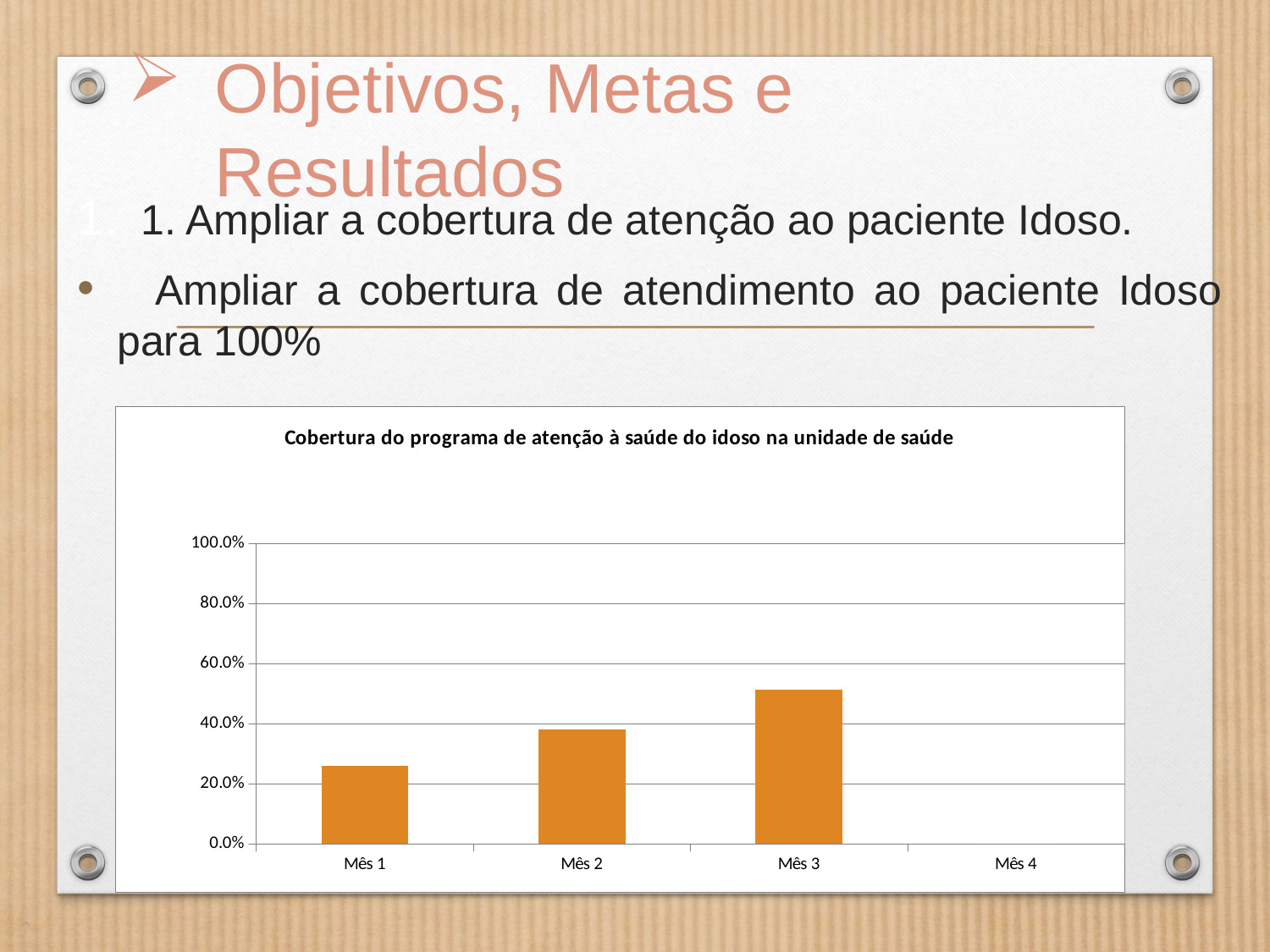
What is the title of the chart? Cobertura do programa de atenção à saúde do idoso na unidade de saúde Is the value for Mês 1 greater or less than 40.0%? less Is the value for Mês 2 greater or less than 20.0%? greater Among the months with a visible bar, which has the lowest value? Mês 1 Which is larger, the value for Mês 1 or the value for Mês 3? Mês 3 What kind of chart is shown on the slide? bar chart Which month has the highest coverage value in the chart? Mês 3 Is the value for Mês 3 greater or less than 60.0%? less Do the values rise or fall from Mês 1 to Mês 3? rise How many categories are shown on the x axis of the chart? 4